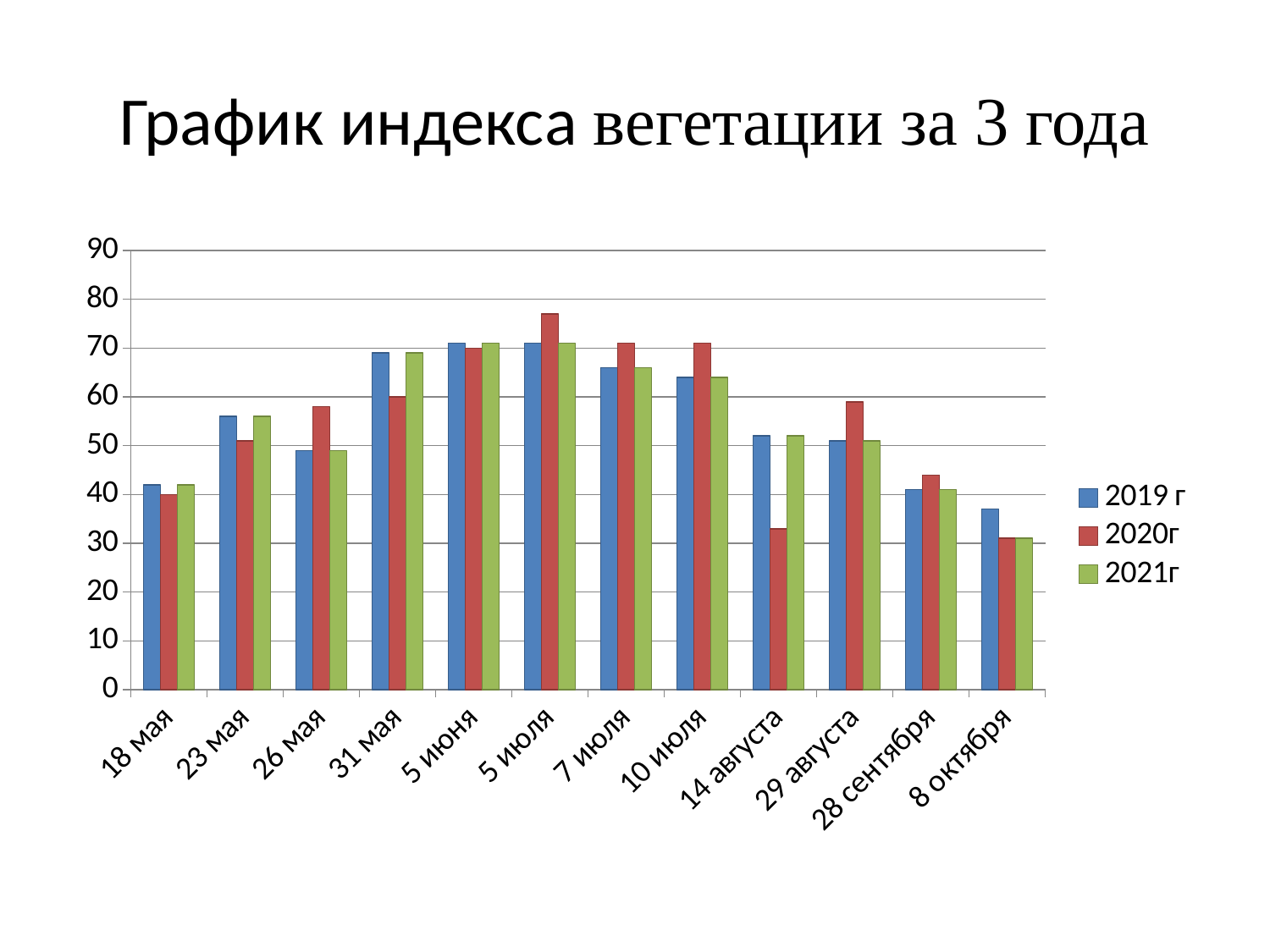
Do the 2019 г values rise or fall from 10 июля to 8 октября? fall On 26 мая, which series has the larger value, 2019 г or 2020г? 2020г What is the title of the chart? График индекса вегетации за 3 года On 29 августа, which series has the larger value, 2019 г or 2020г? 2020г How many dates are shown along the x axis? 12 On which date does the 2019 г series have its lowest value? 8 октября Is the value for 2020г on 14 августа greater or less than 40? less On which date does the 2020г series reach its highest value? 5 июля Which series is shown in red in the legend? 2020г Is the value for 2020г on 5 июля greater or less than 70? greater How many series does the legend list? 3 What kind of chart is shown on the slide? bar chart